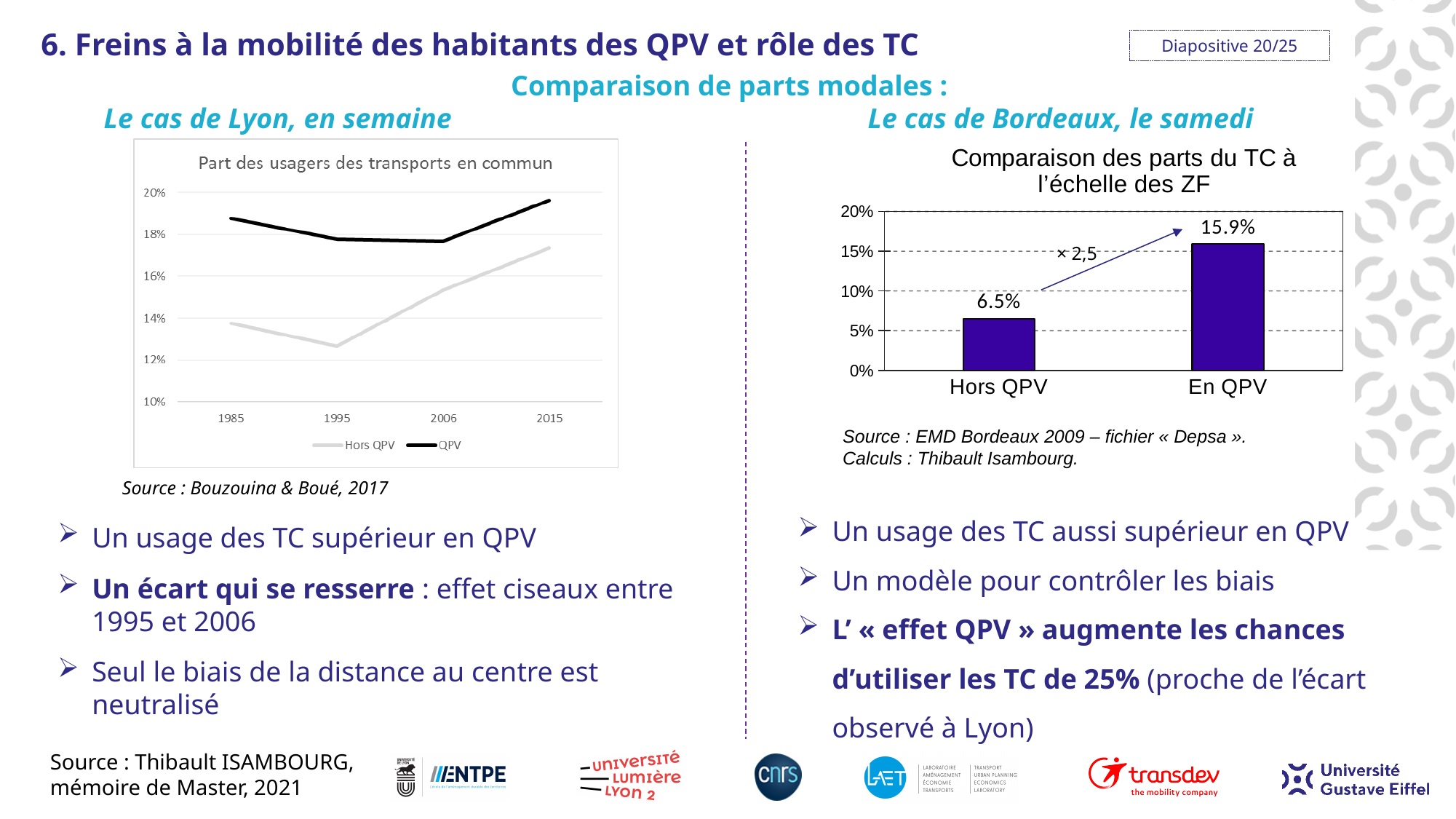
In the chart titled "Comparaison des parts du TC à l'échelle des ZF", what is the value for En QPV? 15.9% In the chart titled "Part des usagers des transports en commun", which series is higher in 2015, Hors QPV or QPV? QPV In the chart titled "Comparaison des parts du TC à l'échelle des ZF", what is the value for Hors QPV? 6.5% In the chart titled "Comparaison des parts du TC à l'échelle des ZF", what is the difference between the En QPV and Hors QPV values? 9.4% In the chart titled "Part des usagers des transports en commun", how many years are shown on the x axis? 4 What kind of chart is the one titled "Part des usagers des transports en commun"? Line chart In the chart titled "Comparaison des parts du TC à l'échelle des ZF", how many categories are shown? 2 In the chart titled "Part des usagers des transports en commun", does the Hors QPV series rise or fall between 1995 and 2015? rise In the chart titled "Comparaison des parts du TC à l'échelle des ZF", which category has the highest value? En QPV In the chart titled "Part des usagers des transports en commun", is the value for Hors QPV in 1995 greater or less than 14%? less In the chart titled "Part des usagers des transports en commun", how many series does the legend list? 2 What kind of chart is the one titled "Comparaison des parts du TC à l'échelle des ZF"? Bar chart